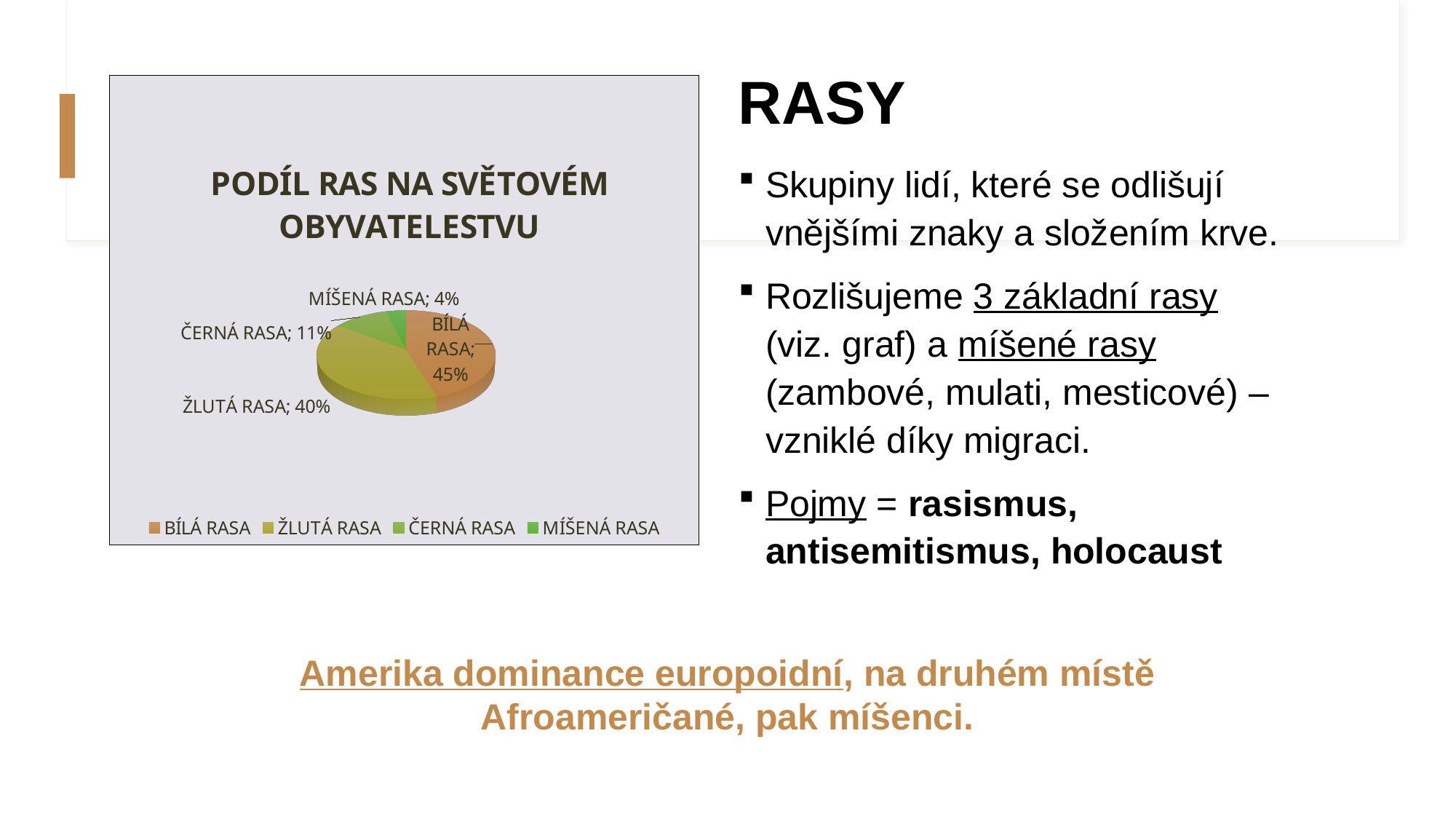
What is the value for ČERNÁ RASA? 11% What is the title of the chart? PODÍL RAS NA SVĚTOVÉM OBYVATELESTVU What is the difference between the values for ČERNÁ RASA and MÍŠENÁ RASA? 7% How many categories does the pie chart show? 4 What kind of chart is shown on the slide? Pie chart What is the value for MÍŠENÁ RASA? 4% What is the difference between the values for BÍLÁ RASA and ŽLUTÁ RASA? 5% Which category has the largest share of the pie? BÍLÁ RASA What is the value for BÍLÁ RASA? 45% Which is larger, the value for ŽLUTÁ RASA or the value for ČERNÁ RASA? ŽLUTÁ RASA What is the value for ŽLUTÁ RASA? 40% Which category has the smallest share of the pie? MÍŠENÁ RASA